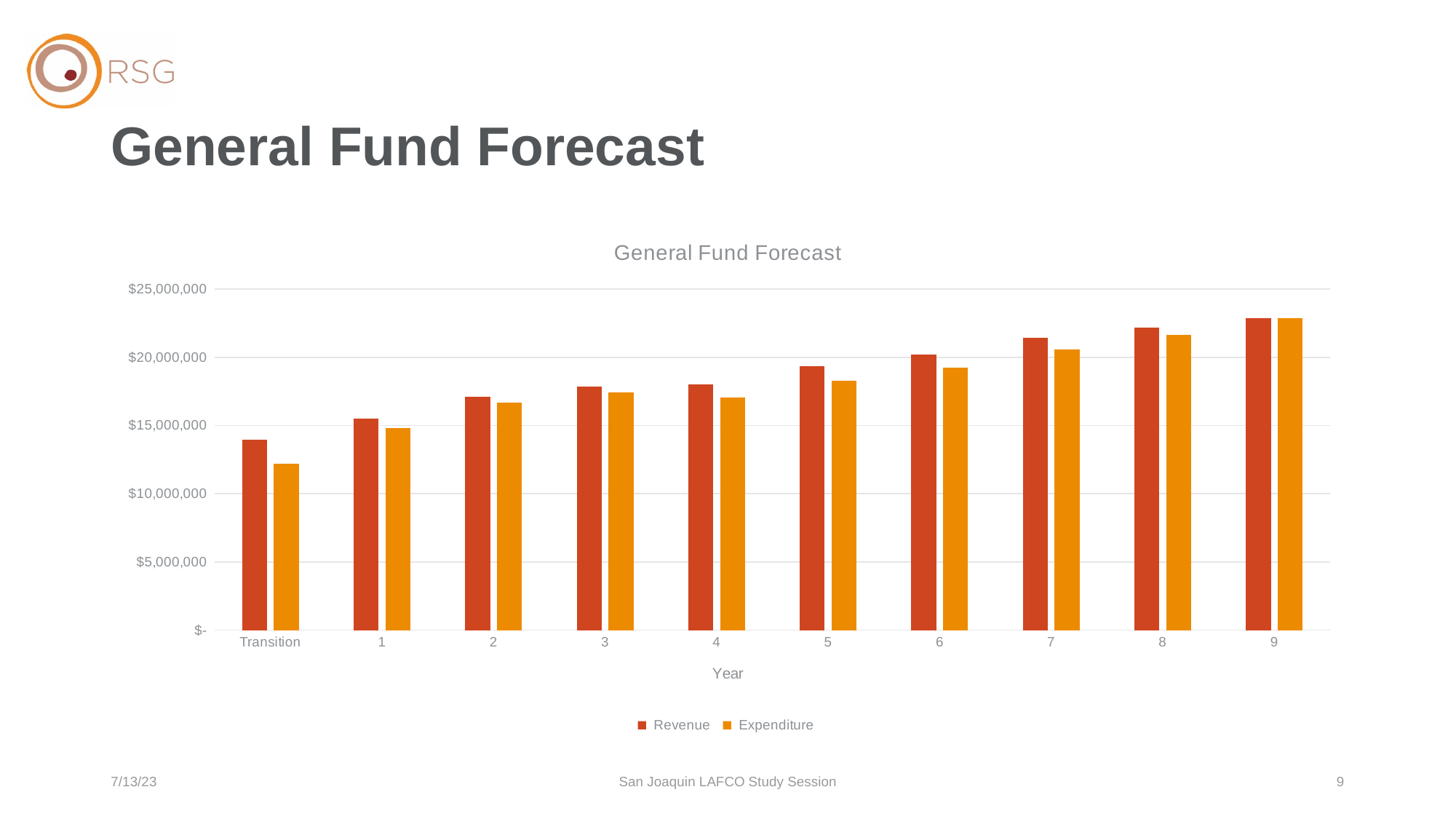
How many categories are shown along the x axis? 10 Which category has the lowest Expenditure value? Transition What is the label on the x axis of the chart? Year Is the Revenue value for Year 5 greater or less than $20,000,000? less Is the Revenue value for Year 7 greater or less than $20,000,000? greater Which category has the lowest Revenue value? Transition What kind of chart is shown on the slide? Bar chart Is the Expenditure value for Transition greater or less than $15,000,000? less For Transition, which is larger, Revenue or Expenditure? Revenue Which category has the highest Revenue value? 9 How many series does the legend list? 2 Do the Revenue values rise or fall from Transition to Year 9? Rise